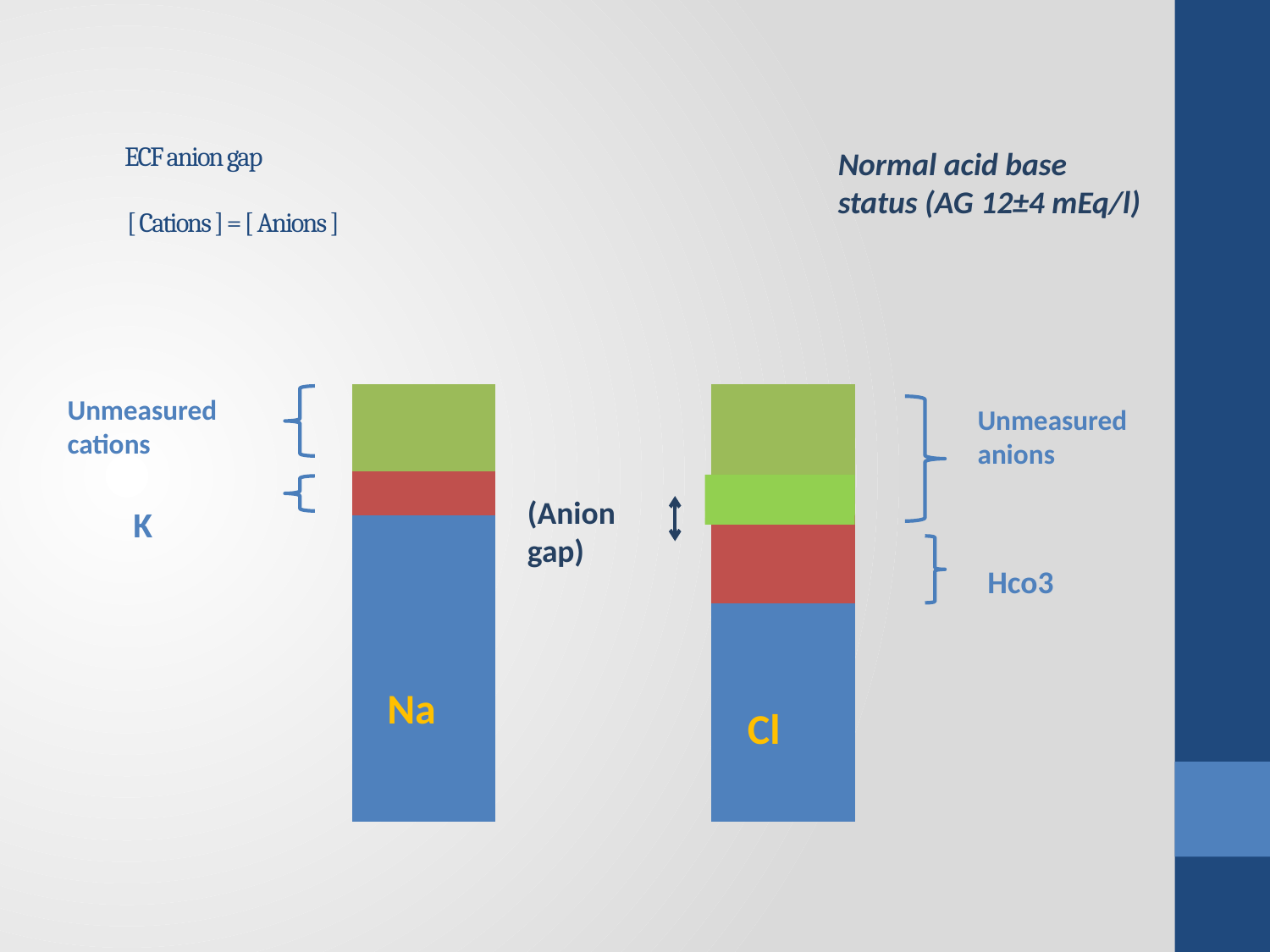
What label is written inside the blue segment of the right bar? Cl In the right bar, which is larger, the Cl segment or the Hco3 segment? Cl In the left bar, which is larger, the Na segment or the K segment? Na Which segment is the largest in the right (anions) bar? Cl What normal anion gap value is stated in the slide's heading? 12±4 mEq/l Which segment is the smallest in the left (cations) bar? K In the right bar, which is larger, the Unmeasured anions segment or the Hco3 segment? Unmeasured anions How many bars are shown in the diagram? 2 What does the double-headed arrow between the two bars represent? Anion gap What kind of chart is shown on the slide? stacked bar chart Which segment is the largest in the left (cations) bar? Na